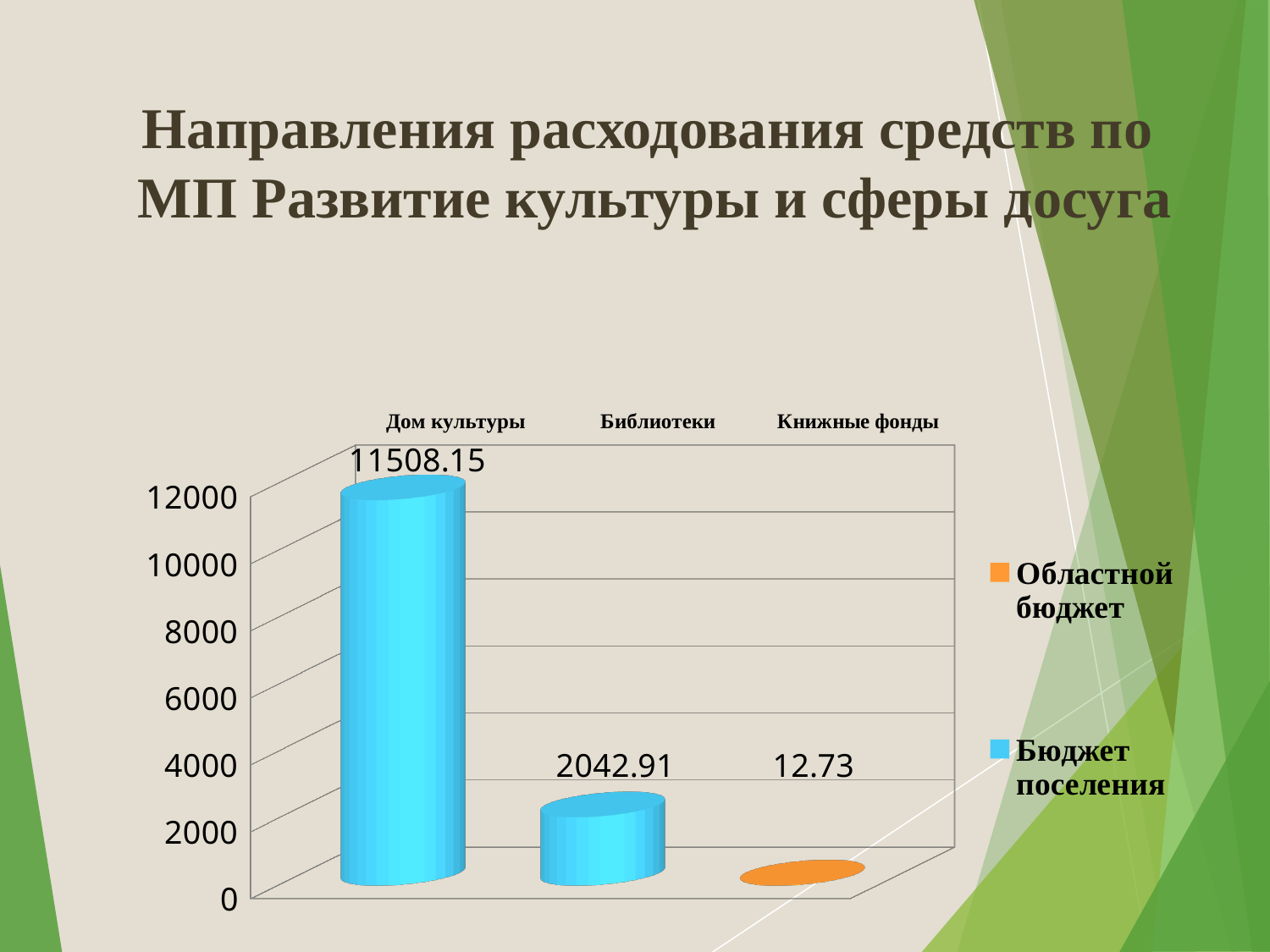
What is the value shown for Дом культуры? 11508.15 Which is larger, the value for Библиотеки or the value for Книжные фонды? Библиотеки What is the value shown for Книжные фонды? 12.73 Is the value for Библиотеки greater or less than 4000? less What is the difference between the values for Дом культуры and Библиотеки? 9465.24 How many categories are shown on the chart? 3 Which legend series is shown in orange? Областной бюджет What is the value shown for Библиотеки? 2042.91 What kind of chart is shown on the slide? bar chart Which category has the highest value? Дом культуры How many series does the legend list? 2 Which category has the lowest value? Книжные фонды